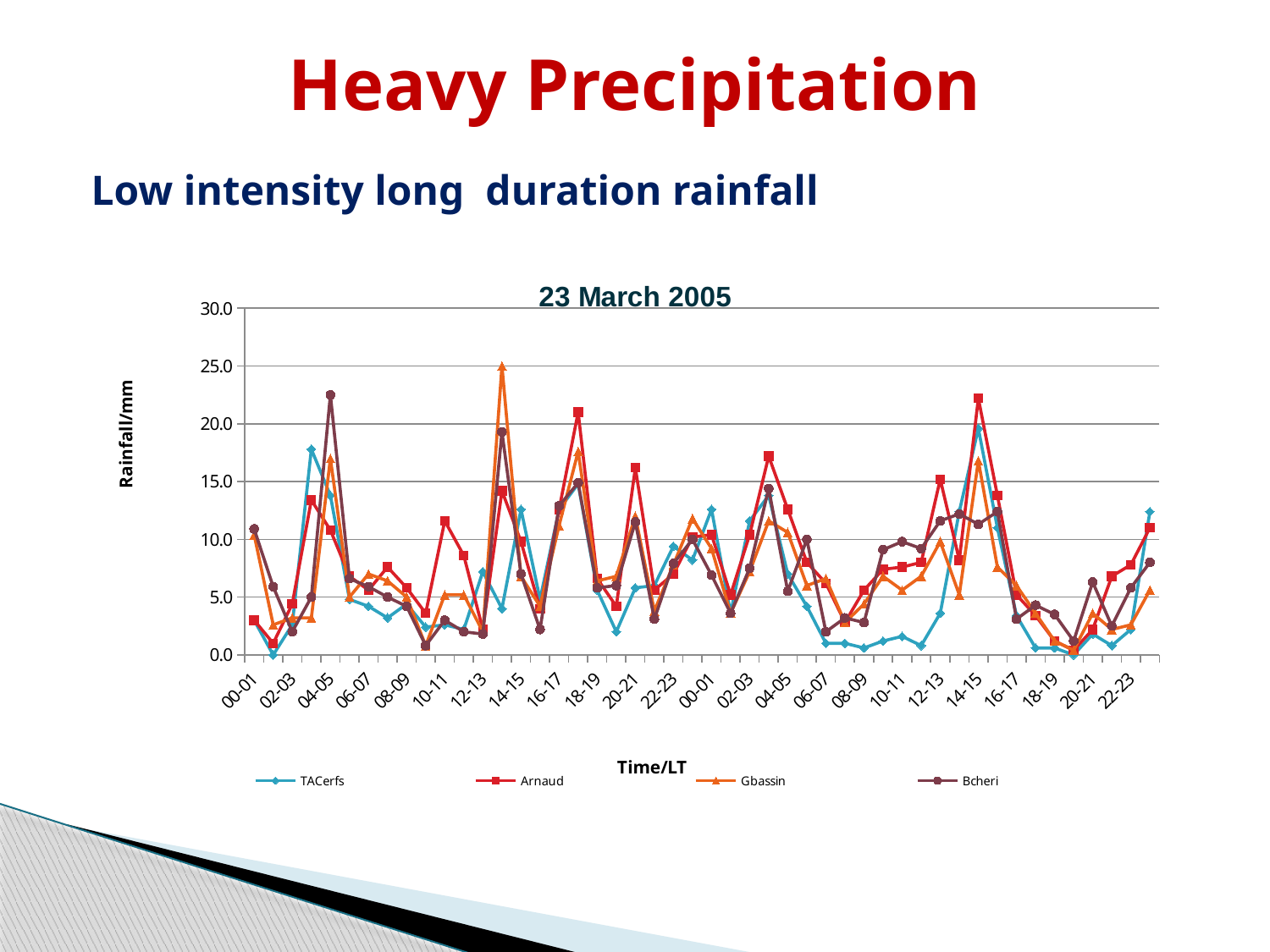
Is the value for TACerfs at 06-07 on the second day greater or less than 5.0? less What is the maximum value shown on the vertical axis? 30.0 What is the title of the chart? 23 March 2005 Is the Gbassin peak at 13-14 on the first day greater or less than 20.0? greater Is the Arnaud peak at 14-15 on the second day greater or less than 20.0? greater How many times does the label 00-01 appear on the horizontal axis? 2 What kind of chart is shown on the slide? Line chart How many series does the legend list? 4 What is the label of the vertical axis? Rainfall/mm Which series reaches the highest peak on the chart? Gbassin